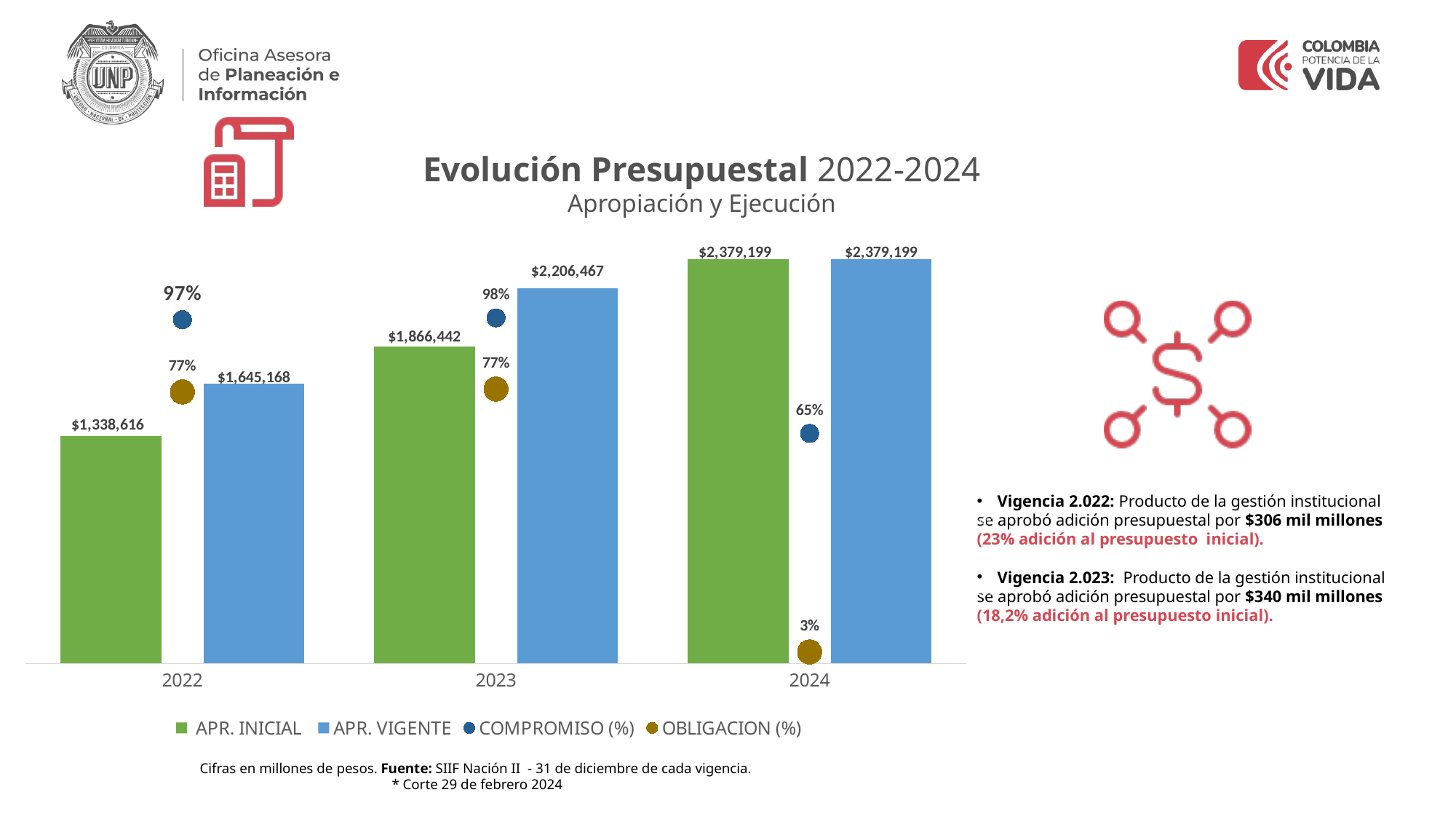
What is the OBLIGACION (%) value for 2024? 3% What is the difference between APR. VIGENTE and APR. INICIAL in 2022? $306,552 What is the COMPROMISO (%) value for 2024? 65% How many years are shown on the x axis of the chart? 3 By how many percentage points does COMPROMISO (%) in 2023 exceed COMPROMISO (%) in 2024? 33 What is the APR. VIGENTE value for 2023? $2,206,467 In which year is the COMPROMISO (%) value highest? 2023 What is the APR. INICIAL value for 2022? $1,338,616 Does the APR. INICIAL value rise or fall from 2022 to 2024? rise How many series does the chart legend list? 4 Which is larger in 2023: APR. INICIAL or APR. VIGENTE? APR. VIGENTE In which year is the APR. INICIAL value lowest? 2022